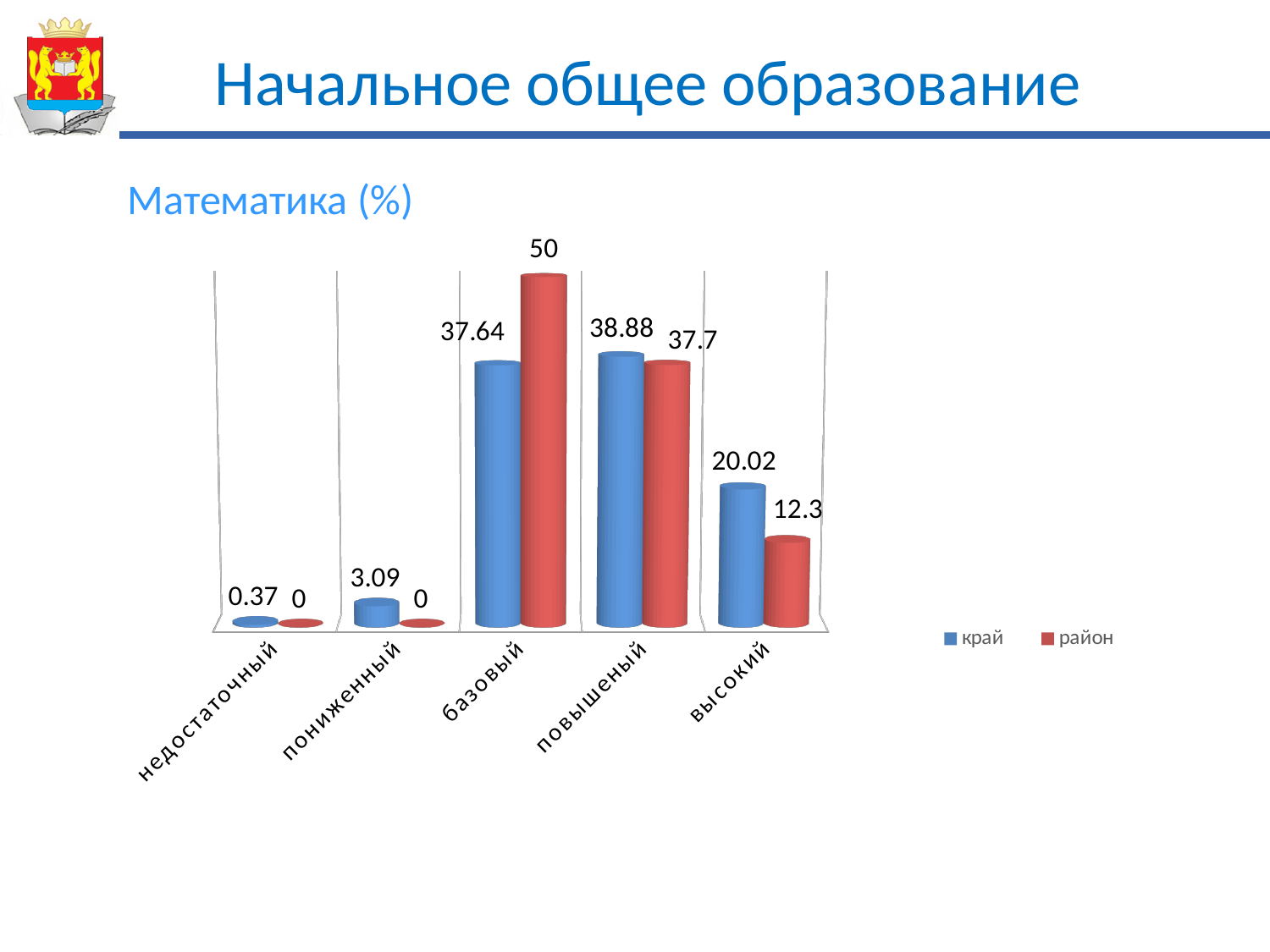
Which category has the highest value for район? базовый What is the title of the chart? Математика (%) What is the value for край in the базовый category? 37.64 What is the difference between край and район in the высокий category? 7.72 How many series does the legend list? 2 How many categories are shown on the x axis? 5 In the повышеный category, which series has the larger value, край or район? край What is the difference between район and край in the базовый category? 12.36 Which category has the lowest value for край? недостаточный What kind of chart is shown on the slide? bar chart What is the value for район in the высокий category? 12.3 What is the value for край in the пониженный category? 3.09